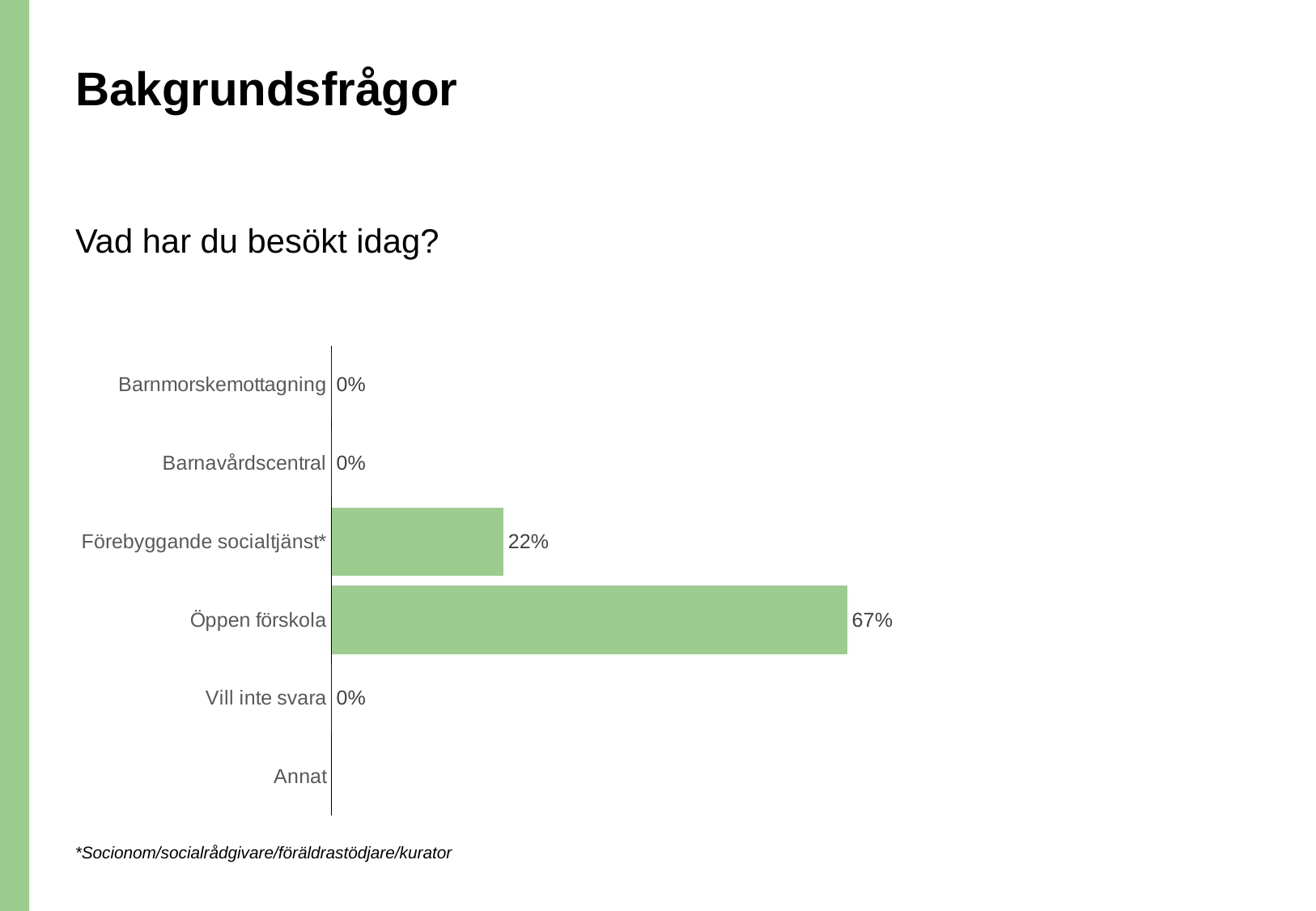
Which category has the highest value? Öppen förskola What is the value for Förebyggande socialtjänst*? 22% What is the value for Vill inte svara? 0% What is the difference between the values for Öppen förskola and Förebyggande socialtjänst*? 45% What is the value for Barnavårdscentral? 0% What is the difference between the values for Förebyggande socialtjänst* and Barnmorskemottagning? 22% What is the value for Öppen förskola? 67% Which is larger, the value for Öppen förskola or the value for Förebyggande socialtjänst*? Öppen förskola What question does the chart on the slide answer? Vad har du besökt idag? What colour are the bars in the chart? Green How many categories are shown on the chart? 6 What kind of chart is shown on the slide? Bar chart